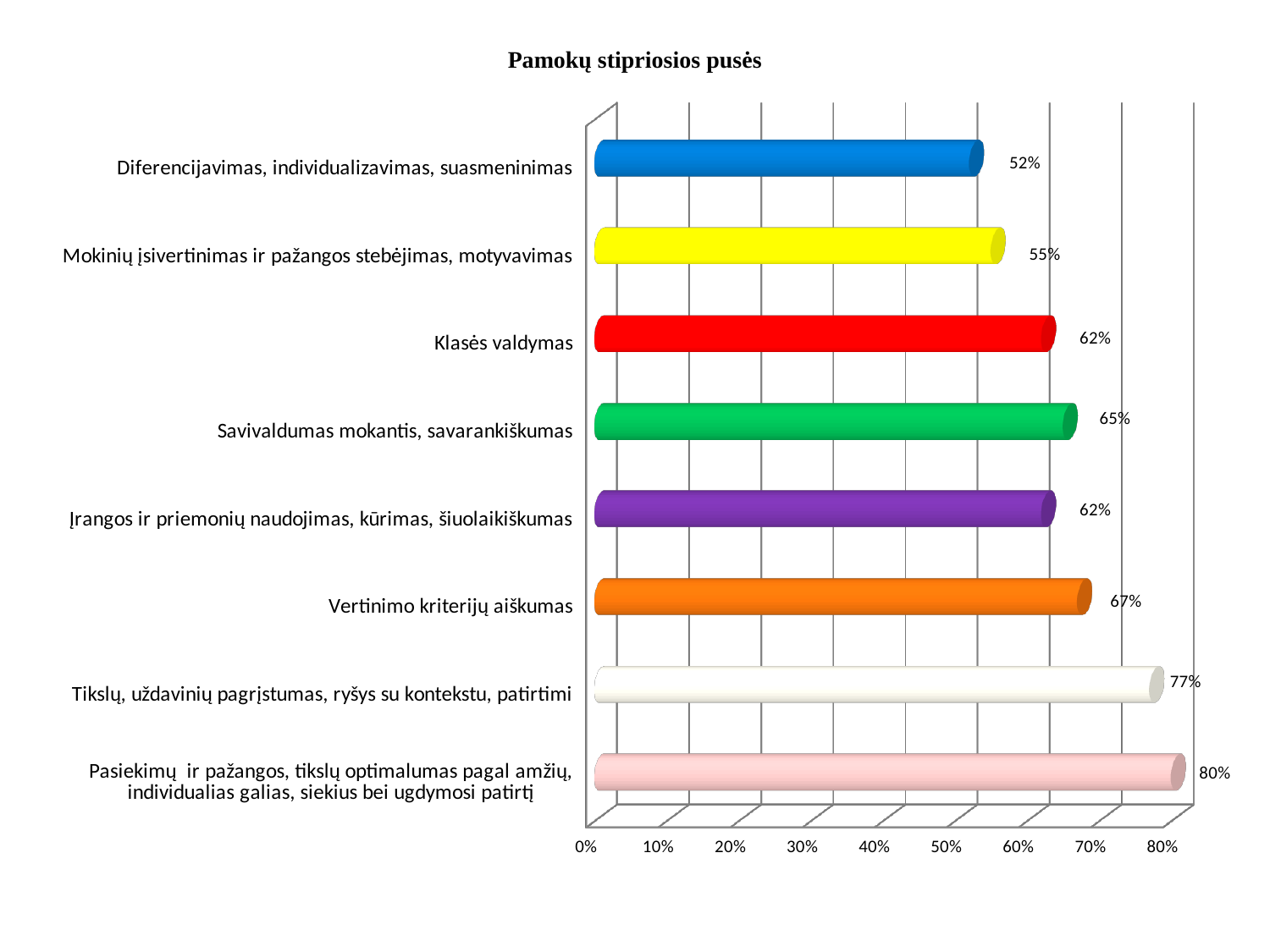
What kind of chart is shown on the slide? bar chart Which category has the highest value? Pasiekimų ir pažangos, tikslų optimalumas pagal amžių, individualias galias, siekius bei ugdymosi patirtį What is the difference between the values for Tikslų, uždavinių pagrįstumas, ryšys su kontekstu, patirtimi and Vertinimo kriterijų aiškumas? 10% What is the value for Vertinimo kriterijų aiškumas? 67% Which is larger: the value for Savivaldumas mokantis, savarankiškumas or the value for Mokinių įsivertinimas ir pažangos stebėjimas, motyvavimas? Savivaldumas mokantis, savarankiškumas What is the value for Diferencijavimas, individualizavimas, suasmeninimas? 52% How many categories are shown in the chart? 8 What is the value for Klasės valdymas? 62% What colour is the bar for Klasės valdymas? red What is the title of the chart? Pamokų stipriosios pusės Which category has the lowest value? Diferencijavimas, individualizavimas, suasmeninimas Is the value for Įrangos ir priemonių naudojimas, kūrimas, šiuolaikiškumas greater or less than 50%? greater